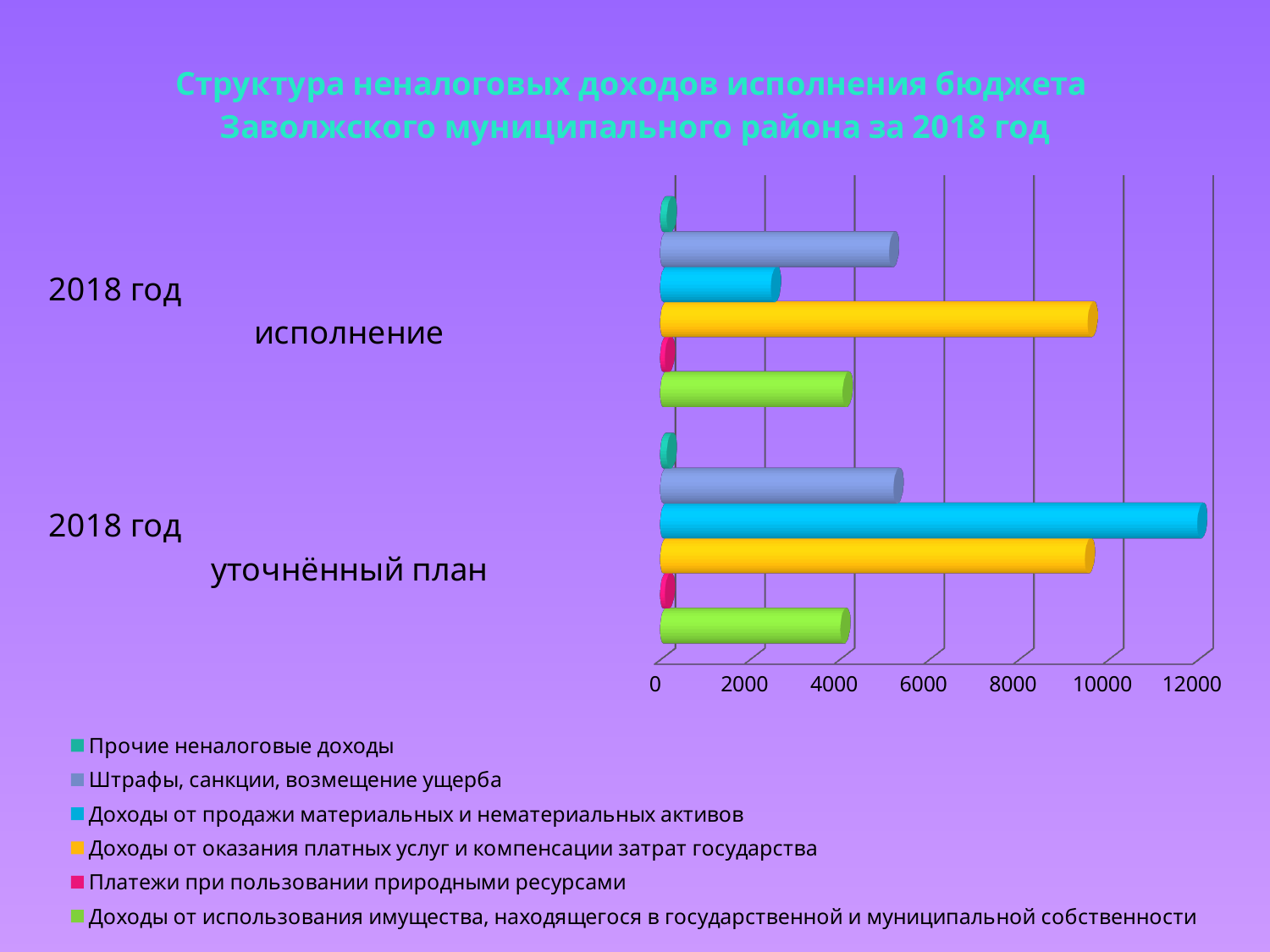
Which series has the longest bar for the category "2018 год исполнение"? Доходы от оказания платных услуг и компенсации затрат государства Is the value of "Доходы от продажи материальных и нематериальных активов" for "2018 год исполнение" greater or less than 4000? less What kind of chart is shown on the slide? bar chart For "Доходы от продажи материальных и нематериальных активов", which category has the larger value: "2018 год исполнение" or "2018 год уточнённый план"? 2018 год уточнённый план How many series does the legend list? 6 Which series has the longest bar for the category "2018 год уточнённый план"? Доходы от продажи материальных и нематериальных активов What is the highest value shown on the horizontal axis of the chart? 12000 What is the title of the chart on the slide? Структура неналоговых доходов исполнения бюджета Заволжского муниципального района за 2018 год Is the value of "Доходы от оказания платных услуг и компенсации затрат государства" for "2018 год исполнение" greater or less than 8000? greater Is the value of "Штрафы, санкции, возмещение ущерба" for "2018 год уточнённый план" greater or less than 4000? greater How many categories are shown on the vertical axis of the chart? 2